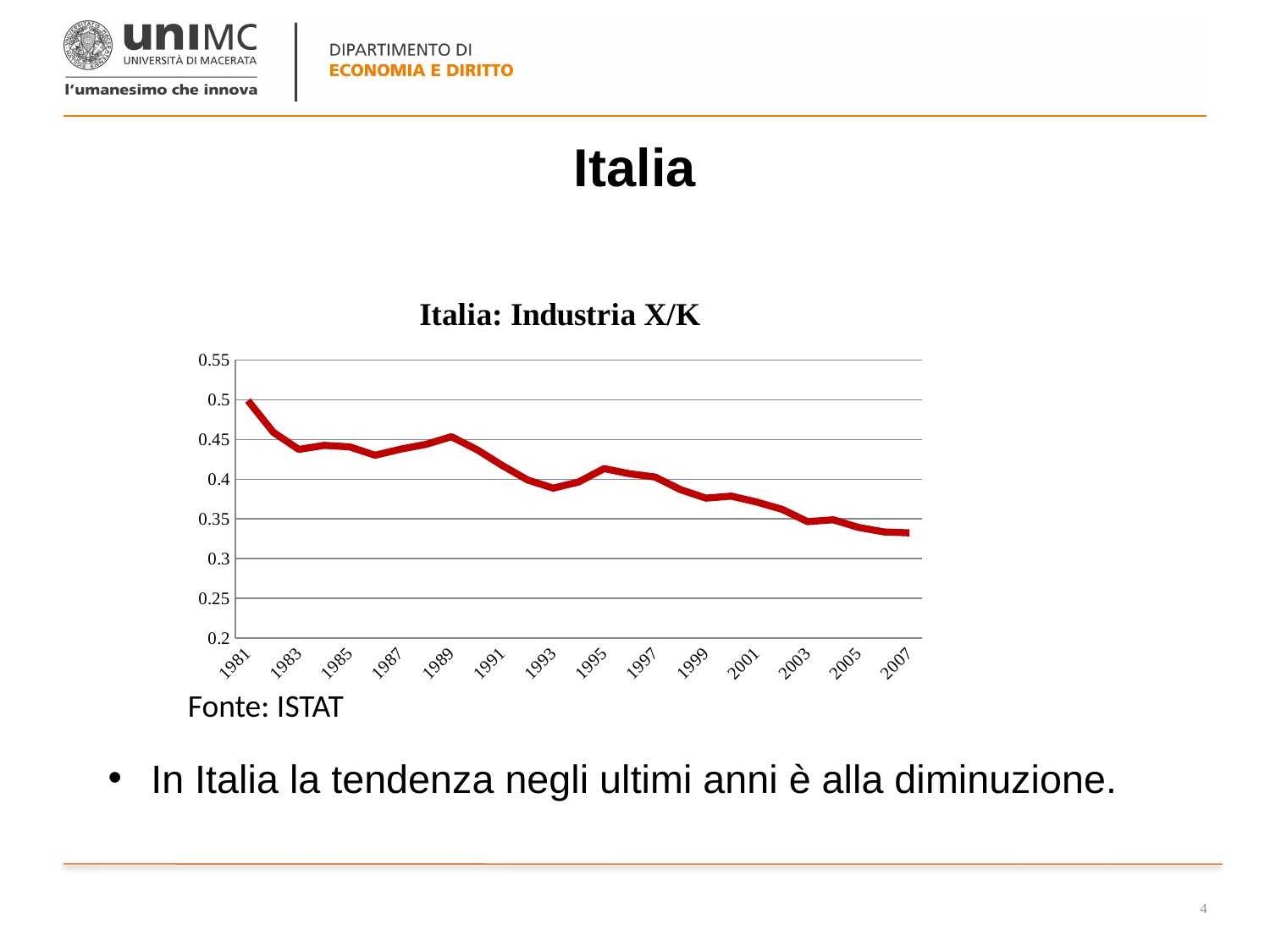
What kind of chart is shown on the slide? line chart Is the value for 1999 greater or less than 0.4? less Which is larger, the value for 1981 or the value for 2007? 1981 Is the value for 2001 greater or less than 0.35? greater How many year labels are shown on the x axis? 14 What source is cited below the chart? ISTAT Which year has the highest value in the chart? 1981 What is the title of the chart? Italia: Industria X/K Is the value for 2007 greater or less than 0.35? less Overall, do the values rise or fall from 1981 to 2007? fall